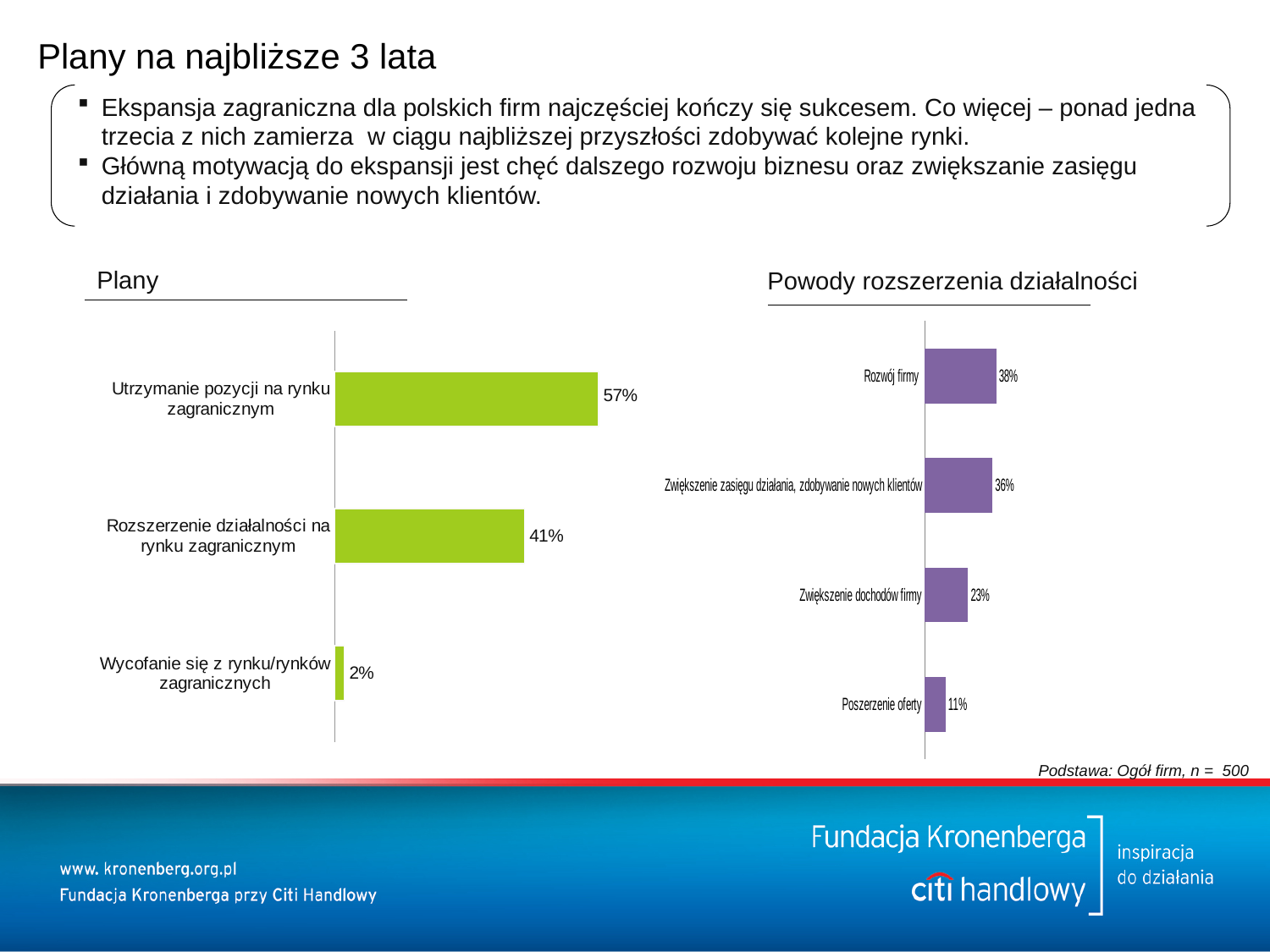
In the 'Plany' chart, what is the difference between 'Utrzymanie pozycji na rynku zagranicznym' and 'Rozszerzenie działalności na rynku zagranicznym'? 16% In the 'Powody rozszerzenia działalności' chart, which category has the highest value? Rozwój firmy In the 'Powody rozszerzenia działalności' chart, which category has the lowest value? Poszerzenie oferty In the 'Powody rozszerzenia działalności' chart, what is the value for 'Rozwój firmy'? 38% What kind of chart is the 'Plany' chart? Bar chart In the 'Plany' chart, what is the value for 'Utrzymanie pozycji na rynku zagranicznym'? 57% In the 'Powody rozszerzenia działalności' chart, what is the difference between 'Zwiększenie dochodów firmy' and 'Poszerzenie oferty'? 12% In the 'Powody rozszerzenia działalności' chart, which is larger: 'Zwiększenie zasięgu działania, zdobywanie nowych klientów' or 'Zwiększenie dochodów firmy'? Zwiększenie zasięgu działania, zdobywanie nowych klientów In the 'Plany' chart, what is the value for 'Rozszerzenie działalności na rynku zagranicznym'? 41% In the 'Powody rozszerzenia działalności' chart, what is the value for 'Zwiększenie dochodów firmy'? 23% In the 'Plany' chart, how many categories are shown? 3 In the 'Plany' chart, which category has the lowest value? Wycofanie się z rynku/rynków zagranicznych